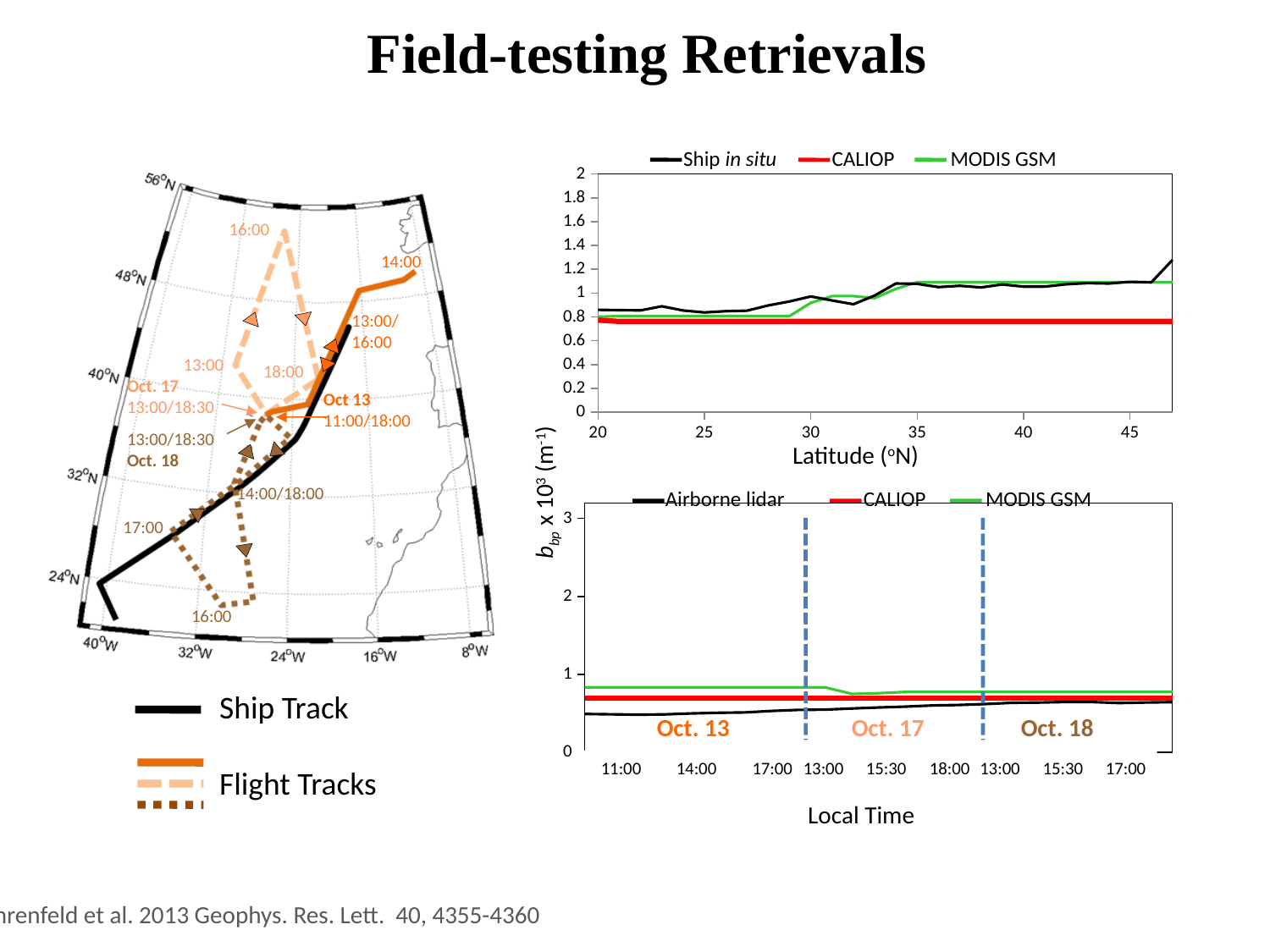
In the top chart, at latitude 45, which series has the larger value: Ship in situ or CALIOP? Ship in situ In the top chart, is the Ship in situ value at latitude 45 greater or less than 1? greater In the bottom chart (plotted against Local Time), how many series does the legend list? 3 In the top chart (plotted against Latitude), how many series does the legend list? 3 In the bottom chart, is the Airborne lidar value at 14:00 on Oct. 13 greater or less than 1? less In the bottom chart, which series is shown in black in the legend? Airborne lidar In the bottom chart, at 14:00 on Oct. 13, which series has the larger value: MODIS GSM or Airborne lidar? MODIS GSM In the top chart, which series is shown in red in the legend? CALIOP In the top chart, is the CALIOP value at latitude 40 greater or less than 0.8? less In the bottom chart, how many dates are labelled along the x axis? 3 In the top chart, does the Ship in situ series generally rise or fall as latitude increases from 20 to 45? Rise What kind of chart is the top chart plotted against Latitude? Line chart